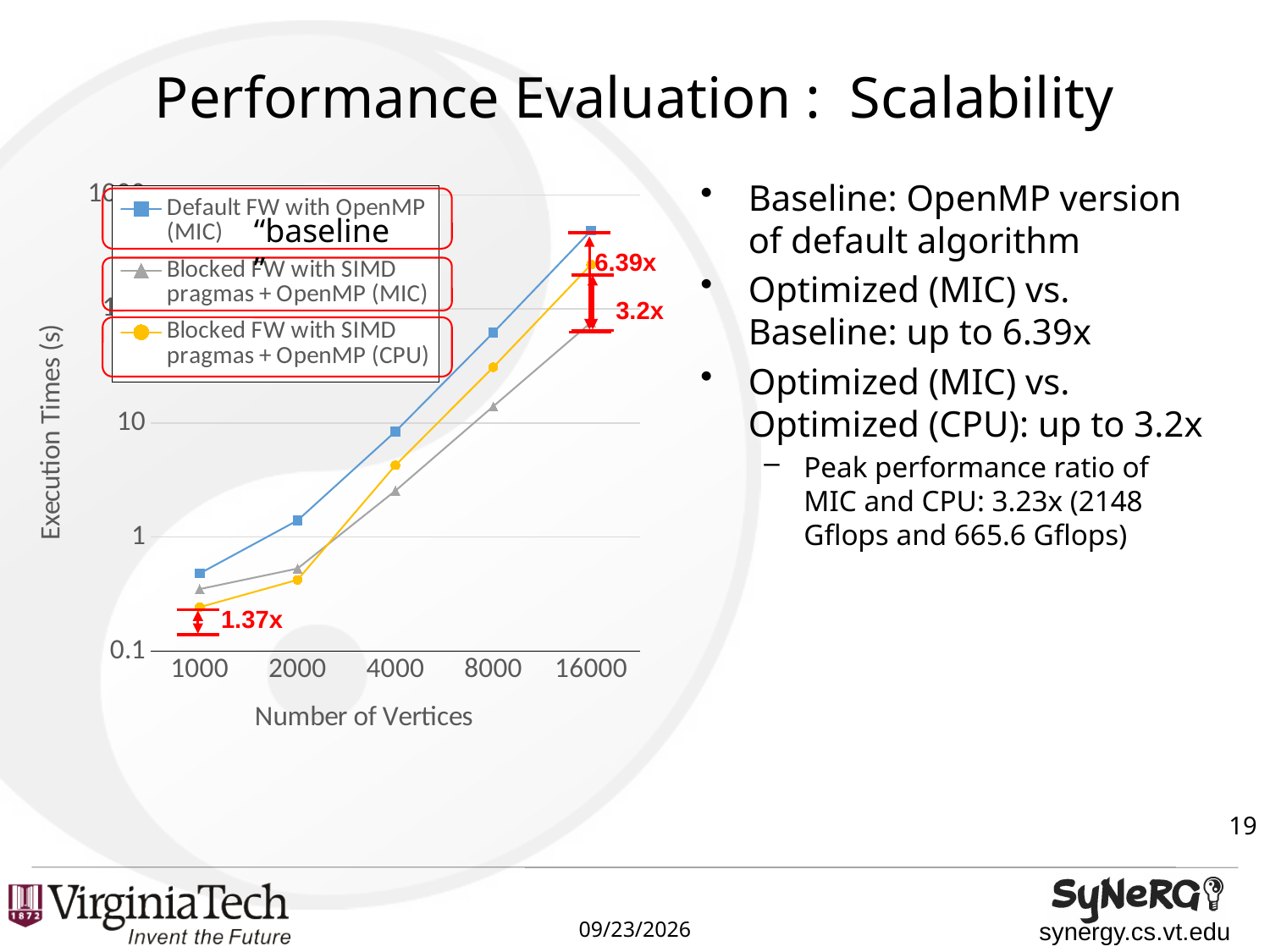
At 16000 vertices, which is larger: the execution time for Default FW with OpenMP (MIC) or for Blocked FW with SIMD pragmas + OpenMP (CPU)? Default FW with OpenMP (MIC) How many values of Number of Vertices are plotted on the x axis? 5 Is the execution time for Default FW with OpenMP (MIC) at 16000 vertices greater or less than 100? greater How many series does the chart legend list? 3 Do the execution times rise or fall as the number of vertices increases? rise Which series has the lowest execution time at 16000 vertices? Blocked FW with SIMD pragmas + OpenMP (MIC) Is the execution time for Blocked FW with SIMD pragmas + OpenMP (MIC) at 1000 vertices greater or less than 1? less Which series has the lowest execution time at 1000 vertices? Blocked FW with SIMD pragmas + OpenMP (CPU) What is the title of the y axis? Execution Times (s) What speedup factor is annotated between the baseline and the Blocked FW (MIC) series at 16000 vertices? 6.39x What kind of chart is shown on the slide? line chart Which series has the highest execution time at 16000 vertices? Default FW with OpenMP (MIC)